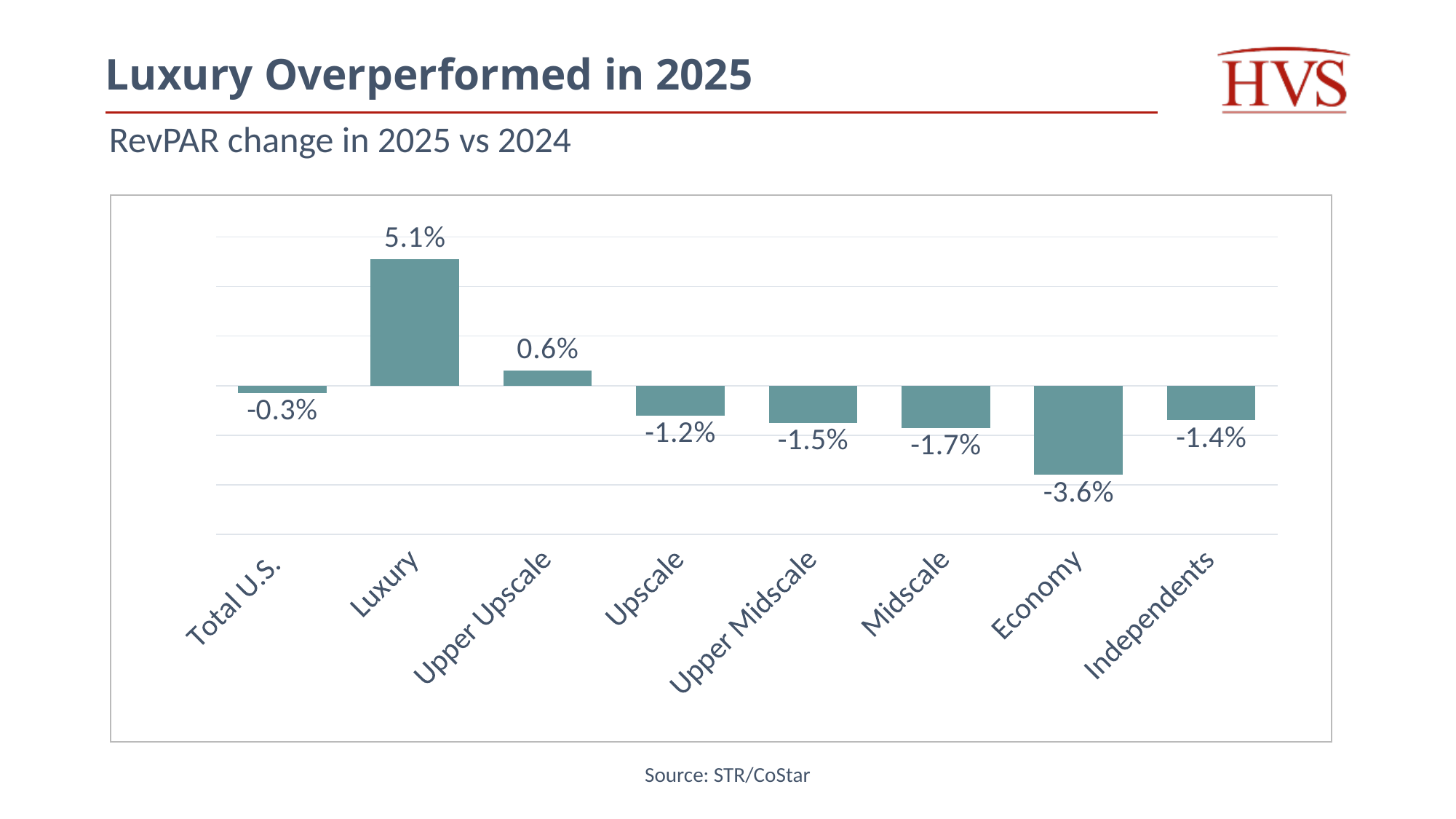
What is the RevPAR change for Luxury? 5.1% What is the RevPAR change for Upper Midscale? -1.5% What kind of chart is shown on the slide? Bar chart What is the source cited for the chart? STR/CoStar How many categories show a positive RevPAR change? 2 What is the RevPAR change for Economy? -3.6% What is the difference between the RevPAR change for Luxury and Upper Upscale? 4.5 percentage points Which has a higher RevPAR change, Upscale or Midscale? Upscale How many categories are shown in the chart? 8 What is the RevPAR change for Total U.S.? -0.3% Which category has the highest RevPAR change? Luxury Which category has the lowest RevPAR change? Economy